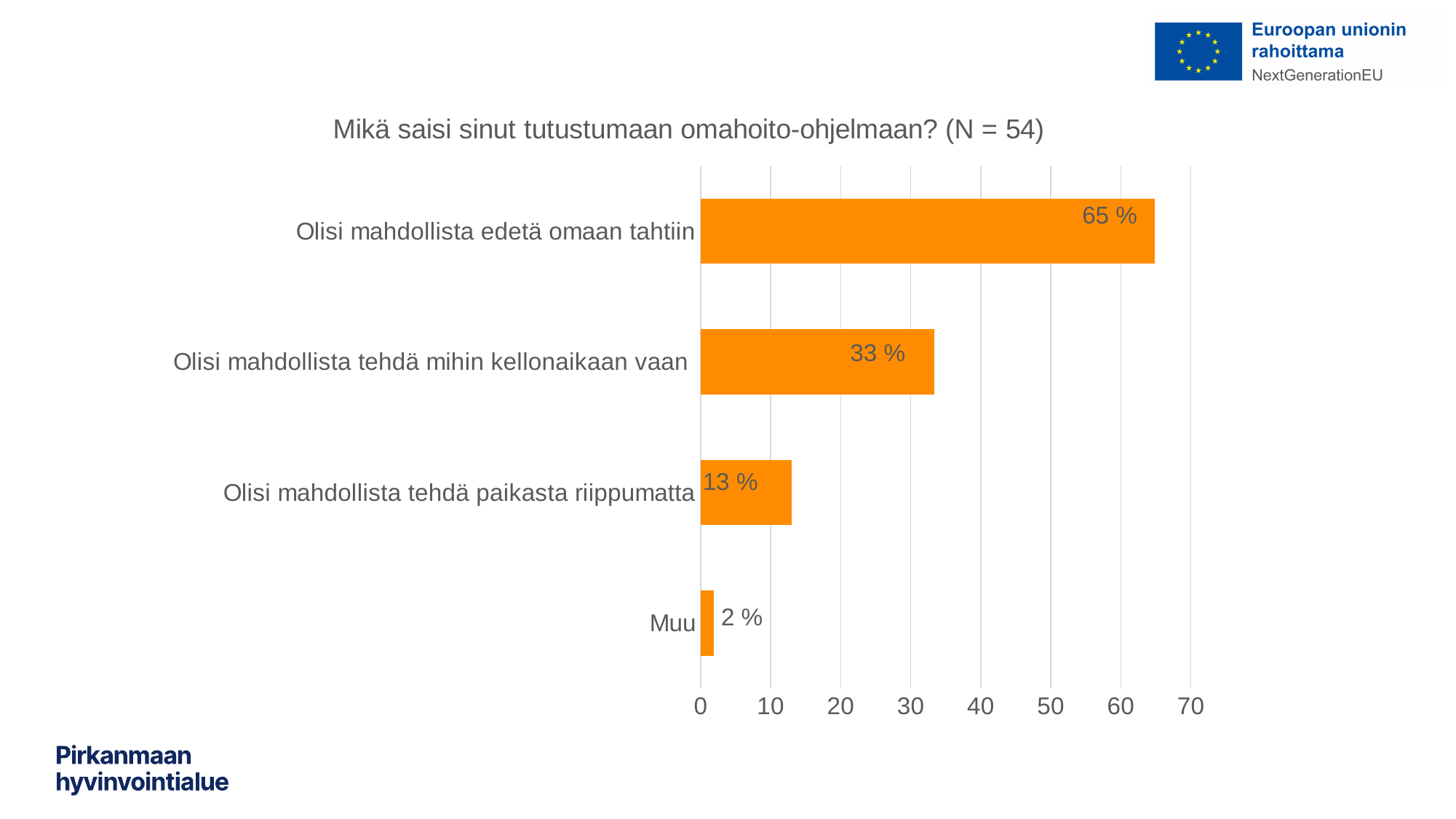
Which category has the highest value? Olisi mahdollista edetä omaan tahtiin Which is larger: the value for "Olisi mahdollista tehdä paikasta riippumatta" or the value for "Muu"? Olisi mahdollista tehdä paikasta riippumatta What is the title of the chart? Mikä saisi sinut tutustumaan omahoito-ohjelmaan? (N = 54) What is the difference between the values for "Olisi mahdollista edetä omaan tahtiin" and "Olisi mahdollista tehdä mihin kellonaikaan vaan"? 32 % What kind of chart is shown on the slide? bar chart Is the value for "Olisi mahdollista tehdä mihin kellonaikaan vaan" greater or less than 40? less What is the value for "Muu"? 2 % What is the value for "Olisi mahdollista edetä omaan tahtiin"? 65 % Which category has the lowest value? Muu What is the value for "Olisi mahdollista tehdä mihin kellonaikaan vaan"? 33 % What is the value for "Olisi mahdollista tehdä paikasta riippumatta"? 13 % How many categories are shown in the chart? 4